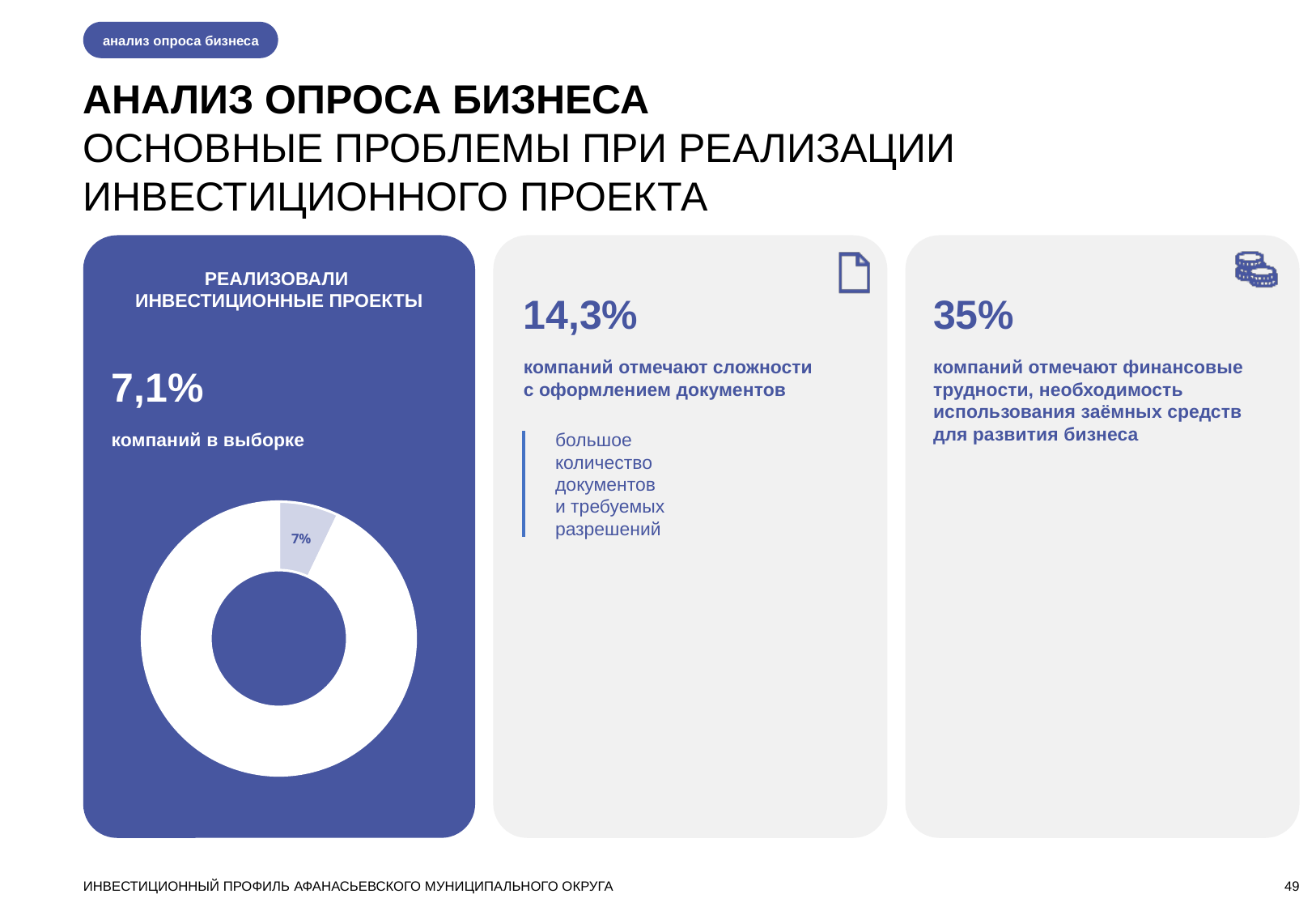
What is the heading of the card that contains the donut chart? РЕАЛИЗОВАЛИ ИНВЕСТИЦИОННЫЕ ПРОЕКТЫ What colour is the labeled 7% slice of the donut chart? light blue Which slice of the donut chart is larger, the labeled 7% slice or the unlabeled white slice? the unlabeled white slice What share of the donut chart does the labeled slice represent? 7% What kind of chart is shown in the left card titled «РЕАЛИЗОВАЛИ ИНВЕСТИЦИОННЫЕ ПРОЕКТЫ»? donut chart How many slices does the donut chart have? 2 What value is printed on the labeled slice of the donut chart? 7%